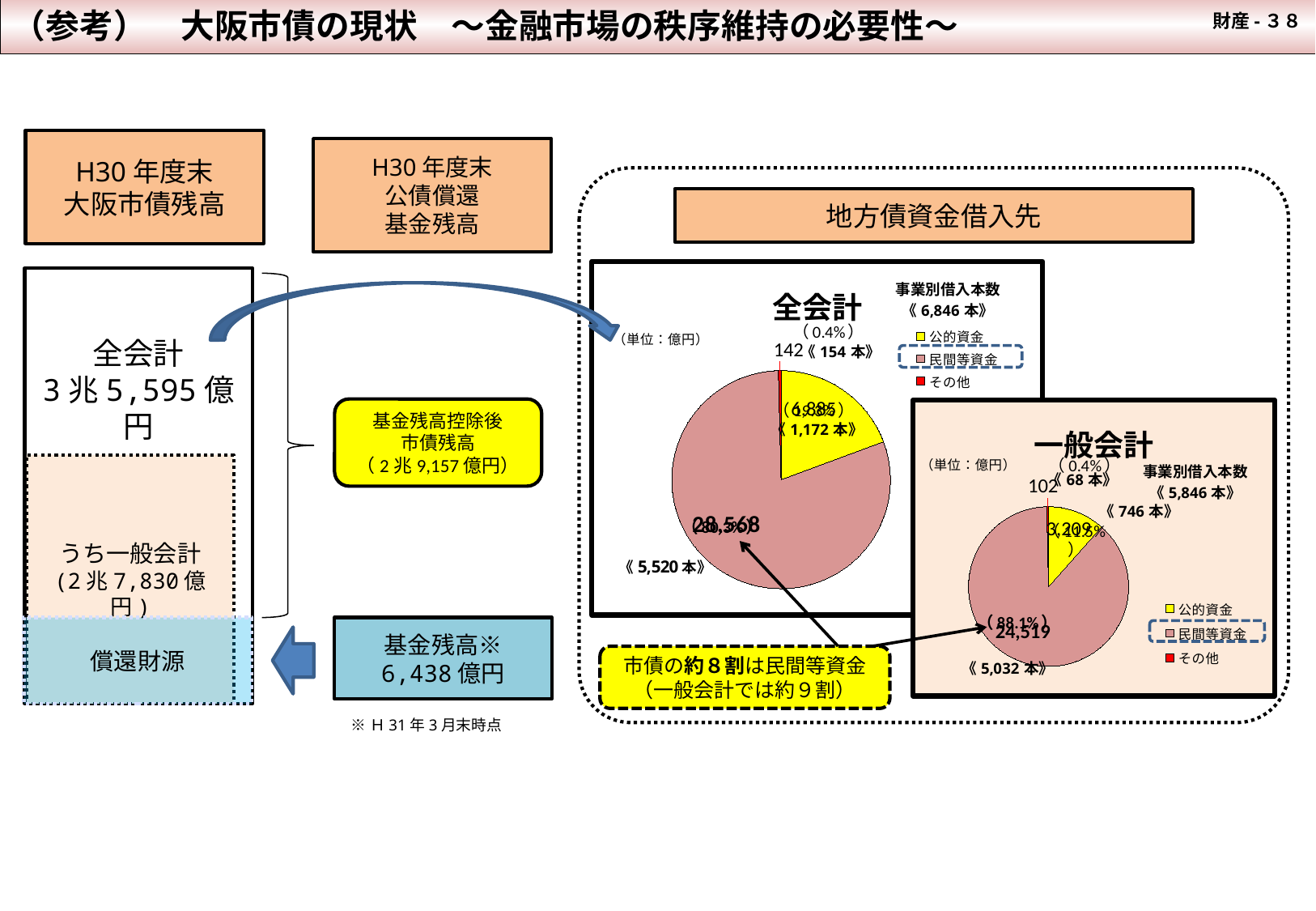
What total number of loans (事業別借入本数) is shown for the 一般会計 pie chart? 5,846本 In the 全会計 pie chart, how many loans (本) are shown for その他? 154本 In the 全会計 pie chart, which category has the smallest slice? その他 In the 全会計 pie chart, which category has the largest slice? 民間等資金 In the 全会計 pie chart, what value (億円) is shown for その他? 142 How many entries does the legend of the 全会計 pie chart list? 3 In the 一般会計 pie chart, what share of the pie does 民間等資金 hold? 88.1% In the 一般会計 pie chart, what value (億円) is shown for その他? 102 What kind of chart is used for 全会計 in the 地方債資金借入先 box? pie chart In the 一般会計 pie chart, what value (億円) is shown for 民間等資金? 24,519 In the 全会計 pie chart, how many loans (本) are shown for 民間等資金? 5,520本 In the 一般会計 pie chart, which is larger, the slice for 公的資金 or the slice for その他? 公的資金